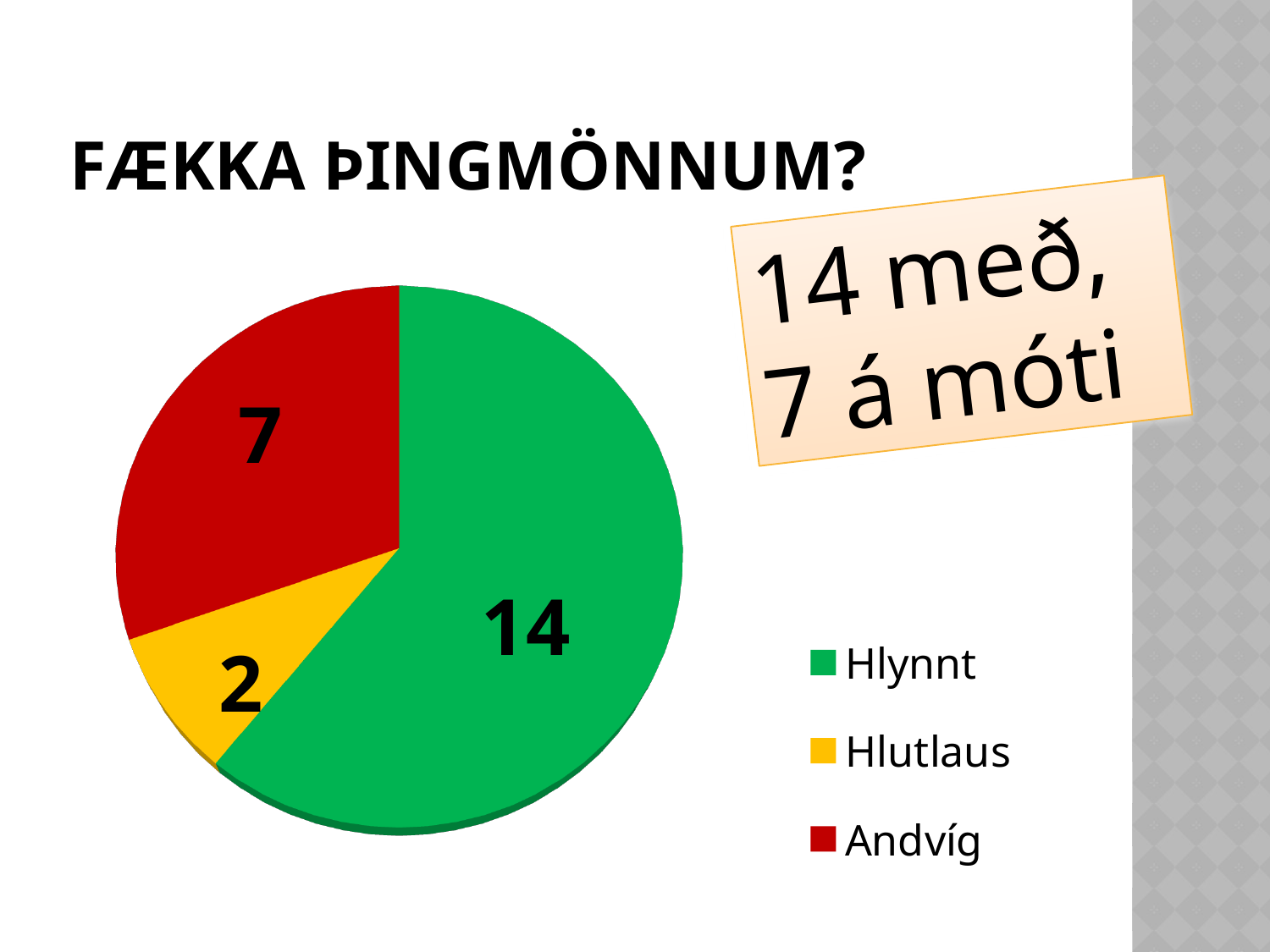
What value is shown for the Hlynnt slice of the pie chart? 14 What kind of chart is shown on the slide? pie chart What colour is the Andvíg slice in the pie chart? red Which category has the smallest slice in the pie chart? Hlutlaus Which category has the largest slice in the pie chart? Hlynnt Which is larger, the Andvíg slice or the Hlutlaus slice? Andvíg What value is shown for the Hlutlaus slice of the pie chart? 2 What value is shown for the Andvíg slice of the pie chart? 7 What is the difference between the Hlynnt value and the Andvíg value? 7 What is the difference between the Andvíg value and the Hlutlaus value? 5 How many slices does the pie chart have? 3 What is the total of all the slices in the pie chart? 23